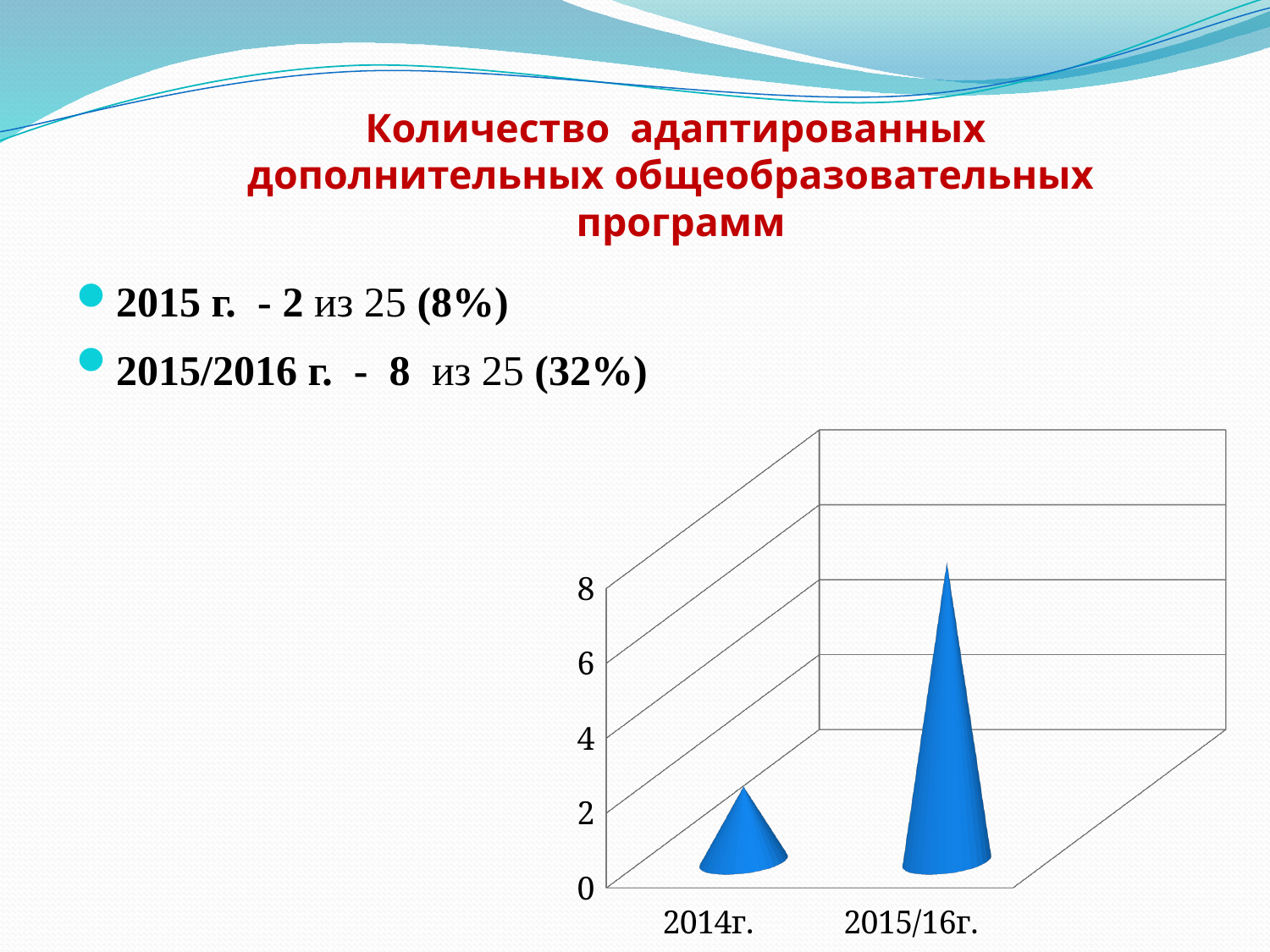
Do the values rise or fall from 2014г. to 2015/16г.? rise Which category has the lowest value in the chart? 2014г. What kind of chart is shown on the slide? bar chart What colour are the bars in the chart? blue Which category has the highest value in the chart? 2015/16г. Is the value for 2015/16г. greater or less than 6? greater How many categories are shown on the x axis of the chart? 2 Is the value for 2014г. greater or less than 4? less What is the highest tick value shown on the vertical axis of the chart? 8 Which is larger in the chart, the value for 2014г. or the value for 2015/16г.? 2015/16г.